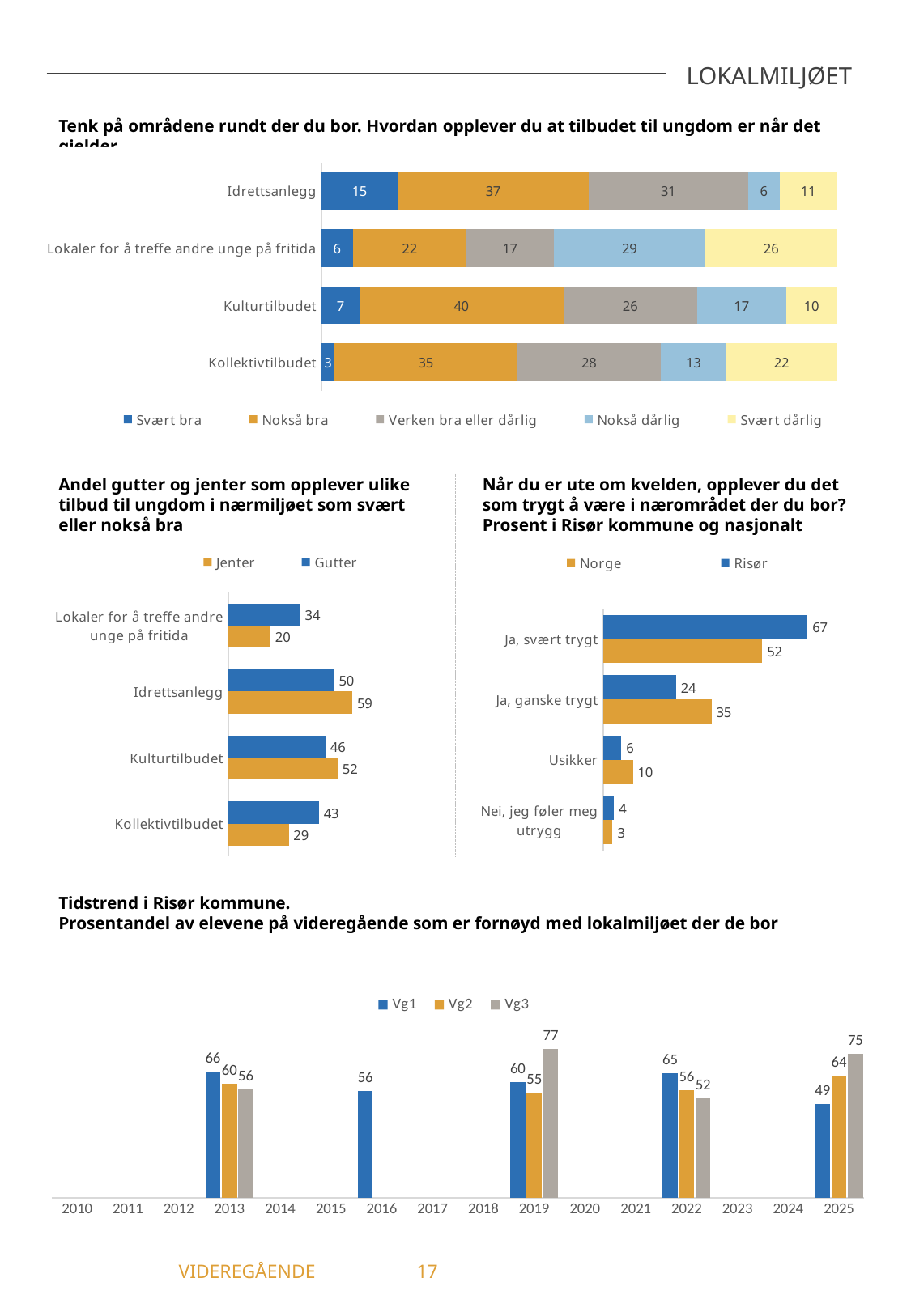
In the chart 'Når du er ute om kvelden, opplever du det som trygt å være i nærområdet der du bor?', what is the difference between Norge and Risør for 'Ja, ganske trygt'? 11 In the chart 'Andel gutter og jenter som opplever ulike tilbud til ungdom i nærmiljøet som svært eller nokså bra', what is the difference between Gutter and Jenter for Kollektivtilbudet? 14 In the top stacked bar chart about tilbudet til ungdom, how many series does the legend list? 5 In the chart 'Andel gutter og jenter som opplever ulike tilbud til ungdom i nærmiljøet som svært eller nokså bra', what is the value for Jenter for Idrettsanlegg? 59 What kind of chart is the 'Tidstrend i Risør kommune' chart? Bar chart In the top stacked bar chart about tilbudet til ungdom, what is the total of the Idrettsanlegg bar? 100 In the top stacked bar chart about tilbudet til ungdom, what is the value for 'Nokså bra' for Kulturtilbudet? 40 In the chart 'Andel gutter og jenter som opplever ulike tilbud til ungdom i nærmiljøet som svært eller nokså bra', which is larger for Kulturtilbudet, Jenter or Gutter? Jenter In the chart 'Tidstrend i Risør kommune', what is the value for Vg3 in 2019? 77 In the chart 'Tidstrend i Risør kommune', which year has the lowest Vg1 value? 2025 In the chart 'Når du er ute om kvelden, opplever du det som trygt å være i nærområdet der du bor?', what is the value for Risør for 'Ja, svært trygt'? 67 In the top stacked bar chart about tilbudet til ungdom, which category has the highest 'Svært dårlig' value? Lokaler for å treffe andre unge på fritida